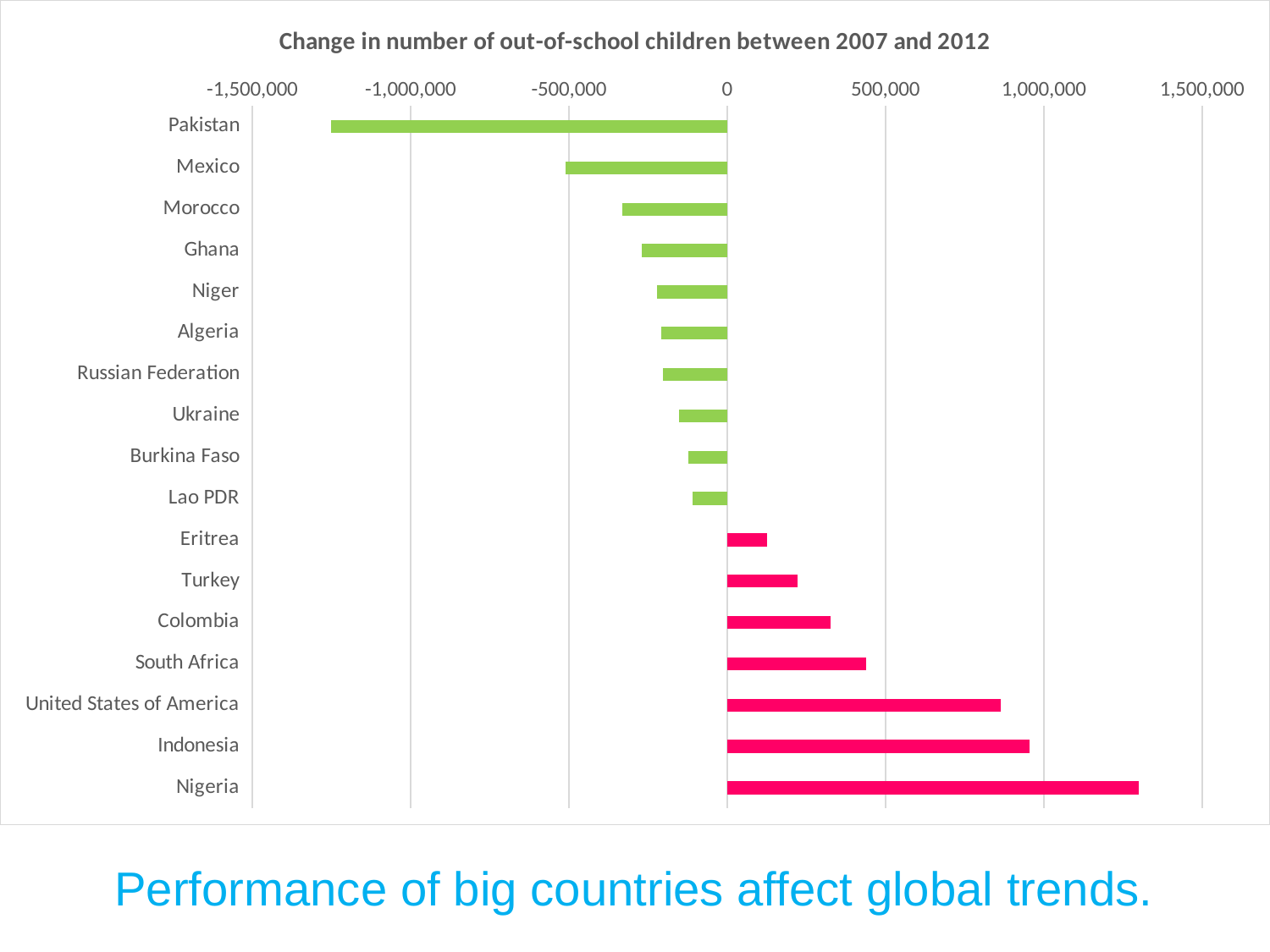
Is the value for United States of America greater or less than 500,000? greater Is the value for Nigeria greater or less than 1,000,000? greater Which country has the lowest value in the chart? Pakistan Is the value for South Africa greater or less than 500,000? less What colour are the bars for countries with a positive change? pink Which is larger, the value for Nigeria or the value for United States of America? Nigeria What is the title of the chart? Change in number of out-of-school children between 2007 and 2012 Which country has the highest value in the chart? Nigeria How many countries are shown in the chart? 17 What kind of chart is shown on the slide? bar chart